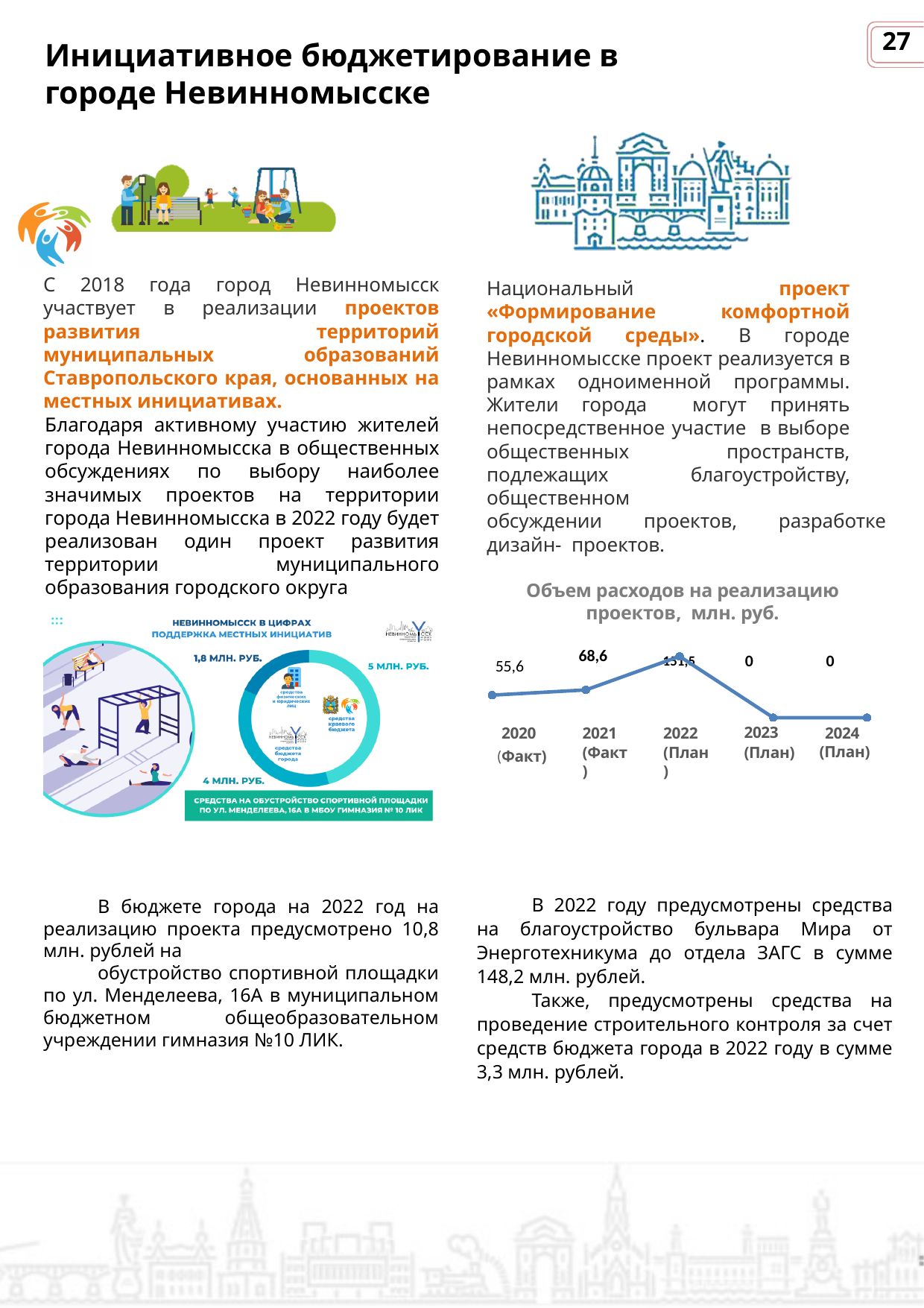
What kind of chart is shown under the title "Объем расходов на реализацию проектов, млн. руб."? line chart Which year has the highest value in the chart "Объем расходов на реализацию проектов, млн. руб."? 2022 (План) What is the value for 2021 (Факт) in the chart "Объем расходов на реализацию проектов, млн. руб."? 68,6 In the chart "Объем расходов на реализацию проектов, млн. руб.", how many years have a value of 0? 2 In the chart "Объем расходов на реализацию проектов, млн. руб.", by how much does the 2021 (Факт) value exceed the 2020 (Факт) value? 13 What is the value for 2020 (Факт) in the chart "Объем расходов на реализацию проектов, млн. руб."? 55,6 What is the title of the line chart on the slide? Объем расходов на реализацию проектов, млн. руб. In the chart "Объем расходов на реализацию проектов, млн. руб.", do the values rise or fall from 2020 to 2022? rise What is the value for 2024 (План) in the chart "Объем расходов на реализацию проектов, млн. руб."? 0 In the chart "Объем расходов на реализацию проектов, млн. руб.", which is larger: the value for 2020 (Факт) or for 2021 (Факт)? 2021 (Факт) What is the value for 2023 (План) in the chart "Объем расходов на реализацию проектов, млн. руб."? 0 How many years are plotted in the chart "Объем расходов на реализацию проектов, млн. руб."? 5